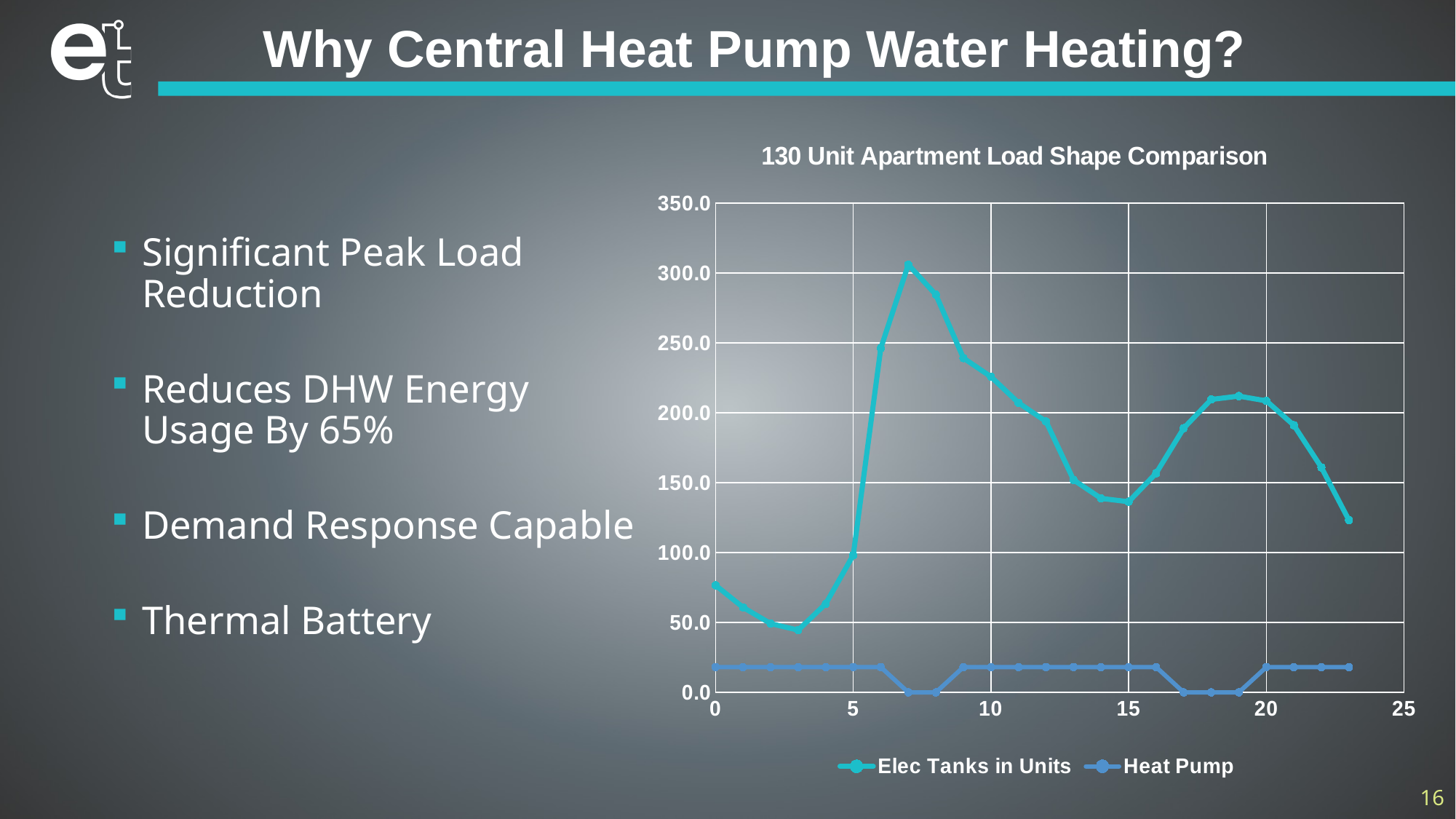
What kind of chart is shown on the slide? line chart Is the value for Elec Tanks in Units at x = 23 greater or less than 150? less Is the value for Elec Tanks in Units at x = 3 greater or less than 100? less Is the value for Elec Tanks in Units at x = 7 greater or less than 250? greater What is the title of the chart? 130 Unit Apartment Load Shape Comparison At which x value does the Elec Tanks in Units series reach its highest point? 7 How many series does the chart legend list? 2 What are the two series named in the chart legend? Elec Tanks in Units and Heat Pump At x = 7, which series has the higher value, Elec Tanks in Units or Heat Pump? Elec Tanks in Units Between x = 19 and x = 23, does the Elec Tanks in Units series rise or fall? fall At which x value does the Elec Tanks in Units series reach its lowest point? 3